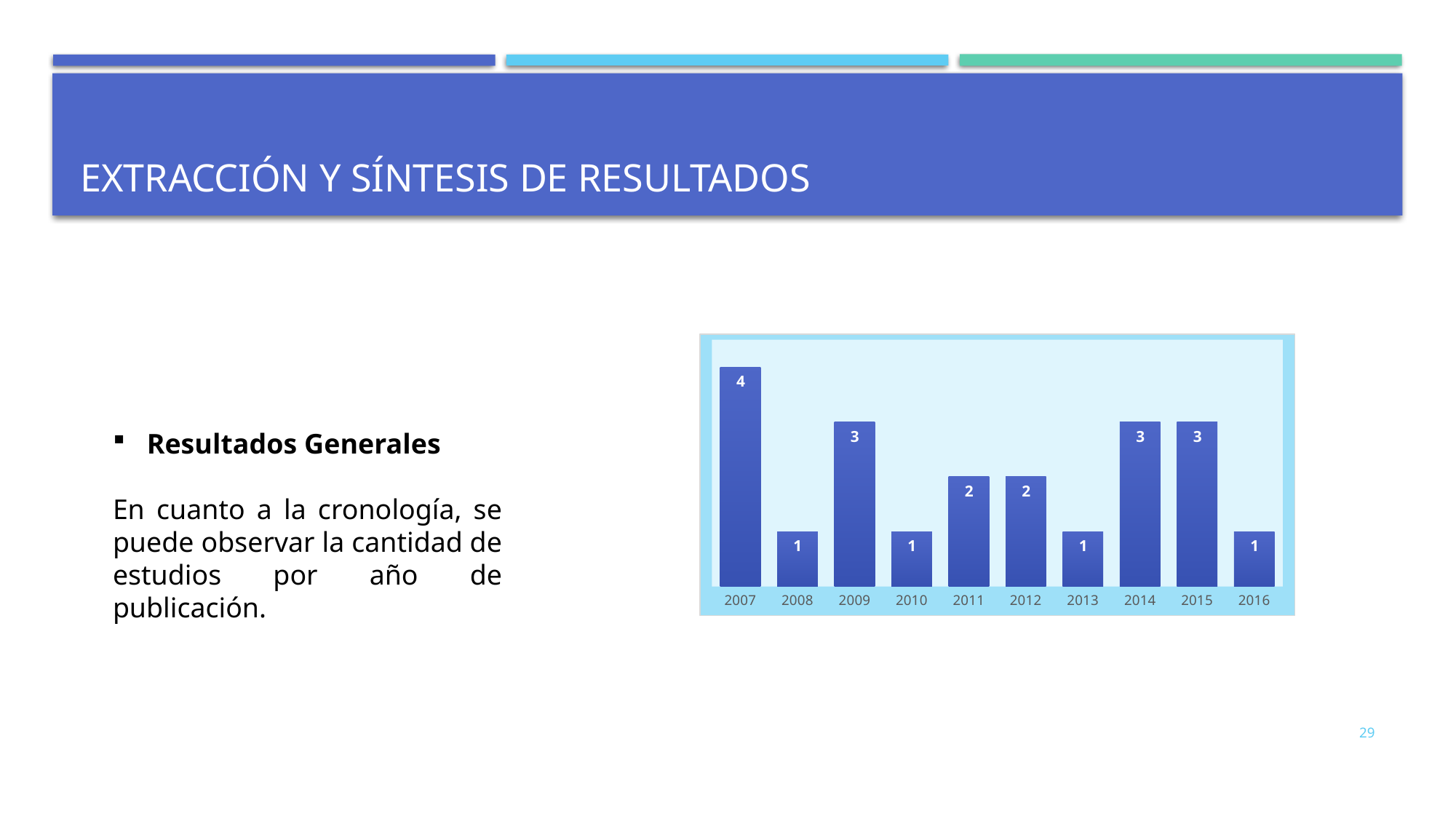
Which is larger, the value for 2009 or the value for 2010? 2009 What kind of chart is shown on the slide? Bar chart Which is larger, the value for 2013 or the value for 2014? 2014 What is the difference between the values for 2007 and 2008? 3 How many years are shown on the x axis? 10 How many years have a value of 1? 4 What is the value for 2011? 2 Do the values rise or fall from 2015 to 2016? Fall Which year has the highest value? 2007 What is the difference between the values for 2014 and 2012? 1 What is the value for 2007? 4 What is the value for 2015? 3